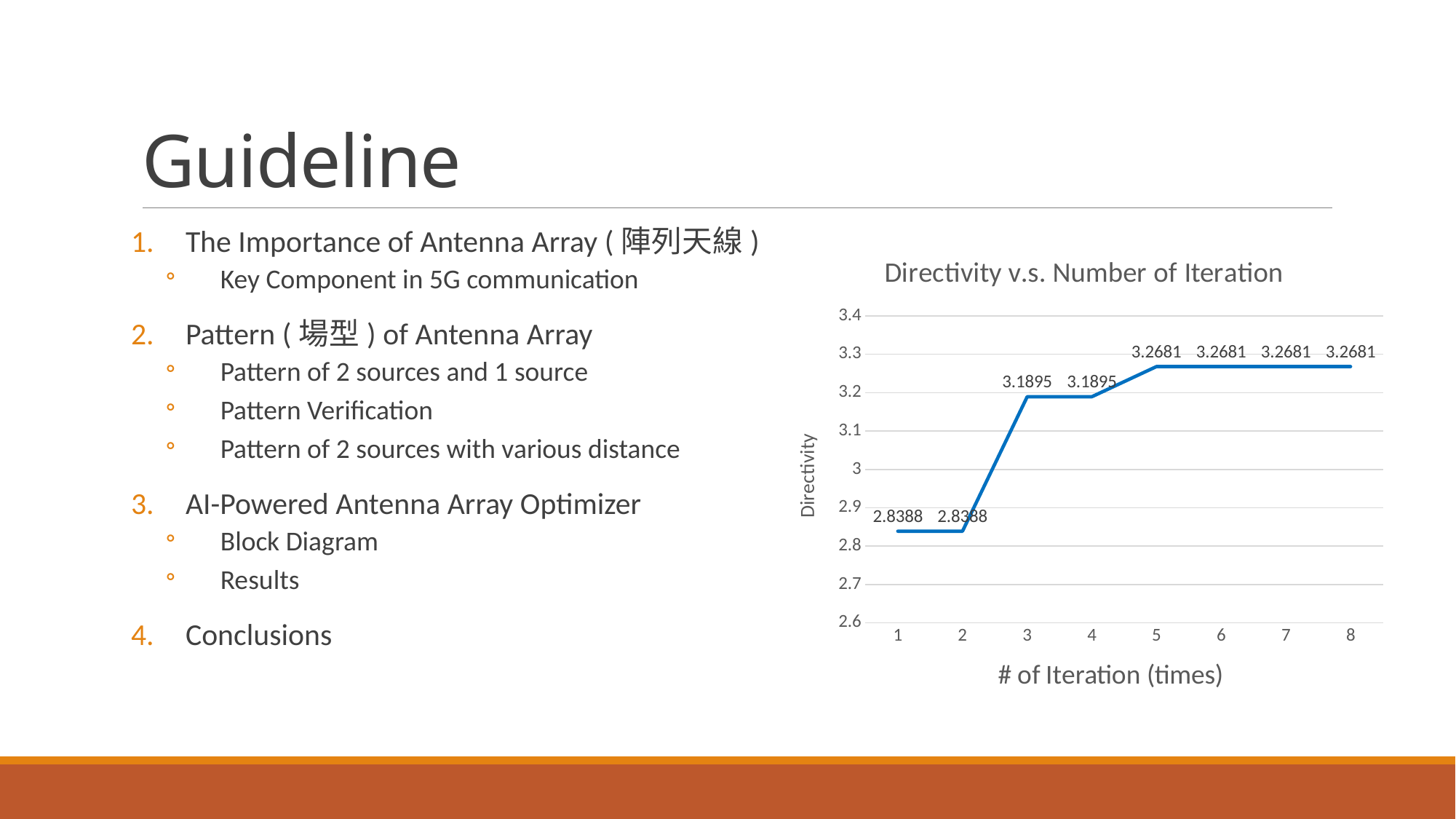
Is the directivity at iteration 1 greater or less than 3? less Which is larger, the directivity at iteration 2 or at iteration 3? iteration 3 What is the directivity value at iteration 1? 2.8388 What is the directivity value at iteration 4? 3.1895 What is the directivity value at iteration 8? 3.2681 What is the difference in directivity between iteration 3 and iteration 2? 0.3507 Does the directivity rise or fall as the number of iterations increases? rise What is the title of the chart? Directivity v.s. Number of Iteration What is the directivity value at iteration 3? 3.1895 How many iteration points are plotted on the chart? 8 What is the difference in directivity between iteration 5 and iteration 4? 0.0786 What kind of chart is shown on the slide? line chart